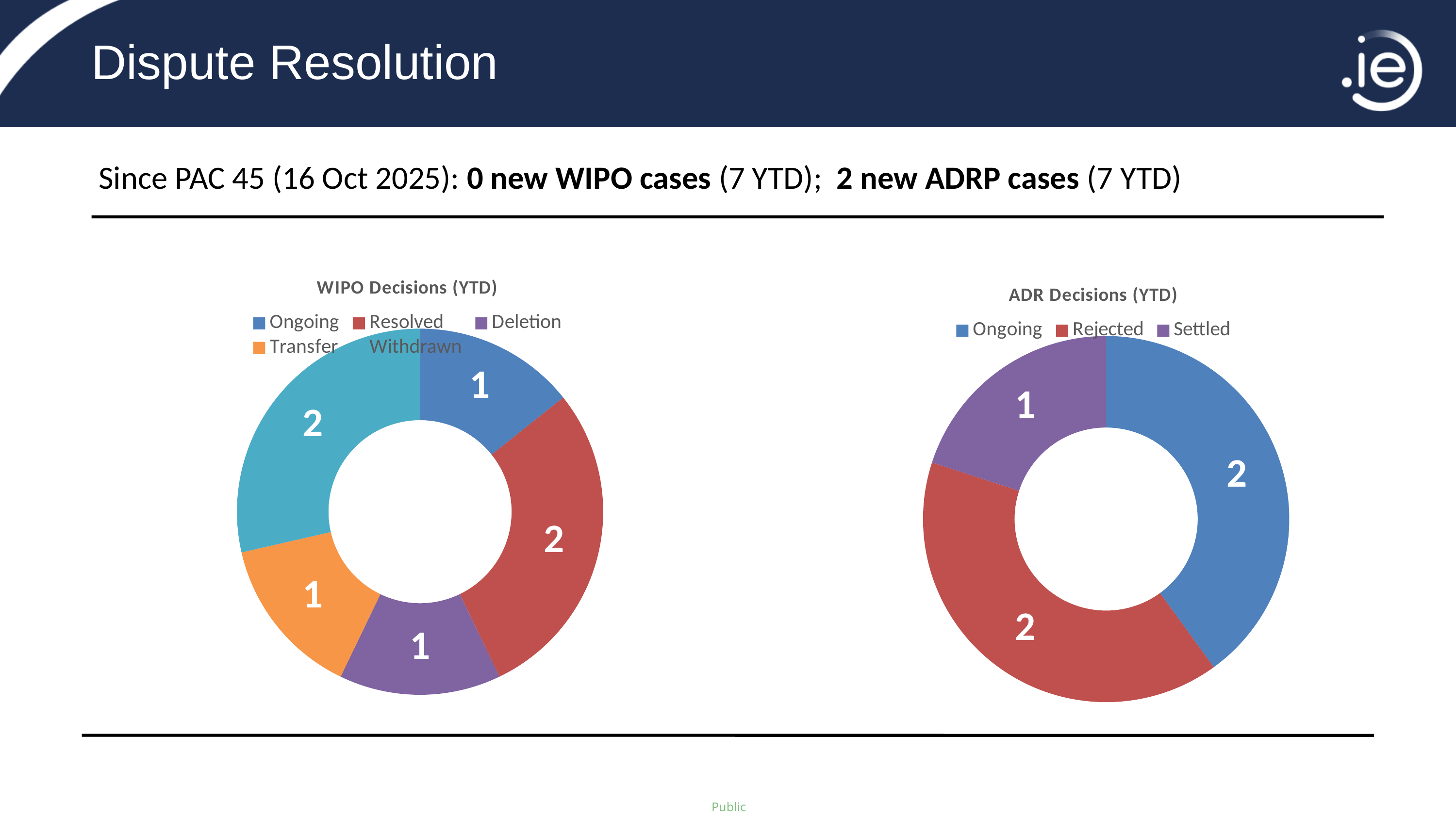
How many categories does the WIPO Decisions (YTD) chart show? 5 In the ADR Decisions (YTD) chart, what is the value for Settled? 1 In the WIPO Decisions (YTD) chart, what is the value for Withdrawn? 2 In the ADR Decisions (YTD) chart, what share of the total does Settled represent? 20% In the WIPO Decisions (YTD) chart, what is the value for Transfer? 1 In the WIPO Decisions (YTD) chart, what is the difference between Withdrawn and Ongoing? 1 In the WIPO Decisions (YTD) chart, which is larger, Resolved or Deletion? Resolved In the WIPO Decisions (YTD) chart, what is the value for Resolved? 2 What kind of chart is the ADR Decisions (YTD) chart? Doughnut chart In the ADR Decisions (YTD) chart, which category has the lowest value? Settled How many categories does the ADR Decisions (YTD) chart show? 3 In the ADR Decisions (YTD) chart, what is the value for Rejected? 2